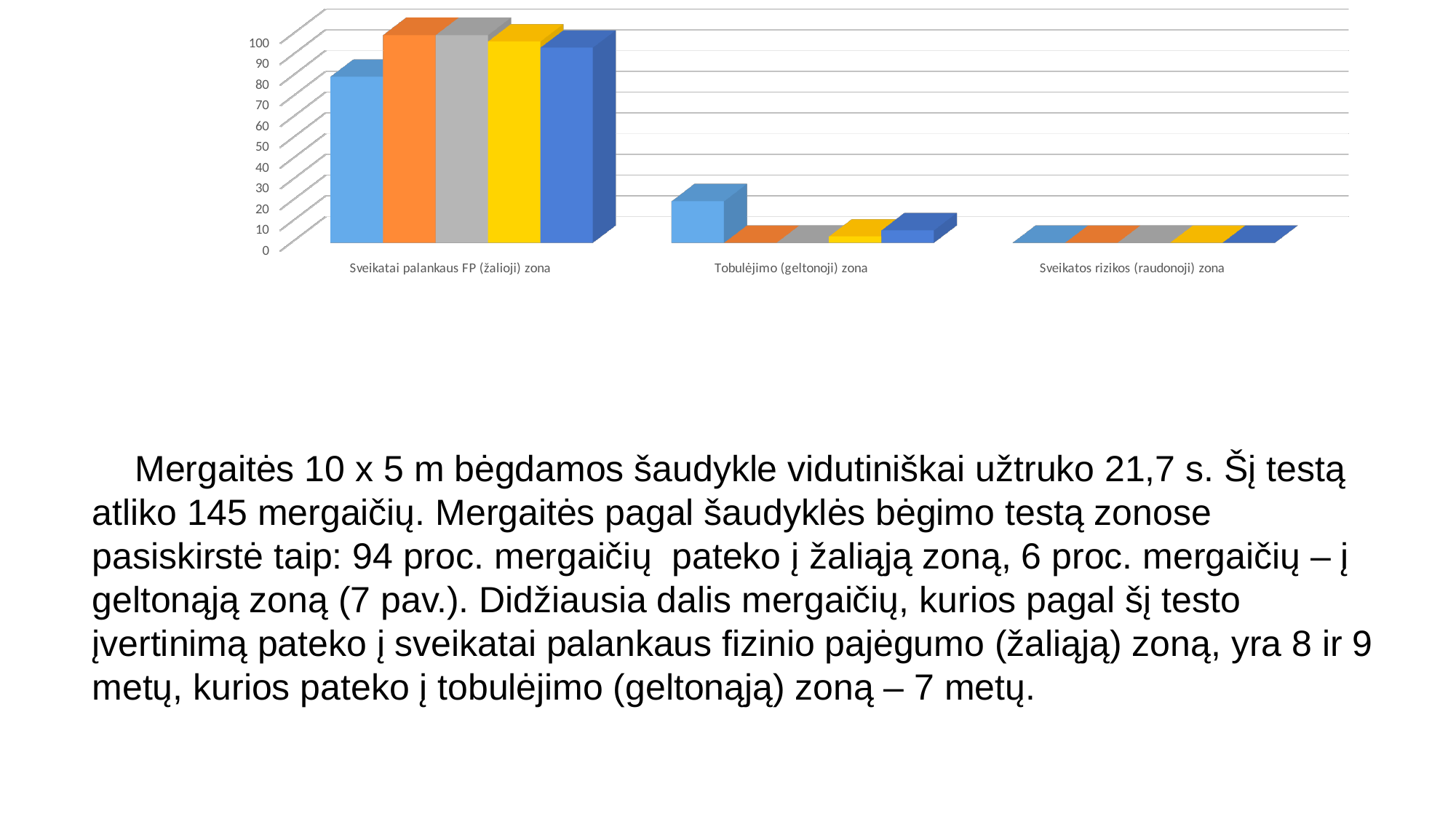
Is the light blue bar larger for Sveikatai palankaus FP (žalioji) zona or for Tobulėjimo (geltonoji) zona? Sveikatai palankaus FP (žalioji) zona Is the value of the light blue bar for Tobulėjimo (geltonoji) zona greater or less than 50? less How many bars are plotted for each category in the chart? 5 What kind of chart is shown on the slide? bar chart Is the value of the orange bar for Sveikatai palankaus FP (žalioji) zona greater or less than 80? greater In the Sveikatai palankaus FP (žalioji) zona category, which bar is taller: the light blue one or the orange one? the orange one Which category has the tallest bars in the chart? Sveikatai palankaus FP (žalioji) zona Is the value of the orange bar for Sveikatos rizikos (raudonoji) zona greater or less than 10? less How many categories are shown on the x axis of the chart? 3 Do the bar values rise or fall moving from left to right along the x axis? fall Which category has the lowest bars in the chart? Sveikatos rizikos (raudonoji) zona